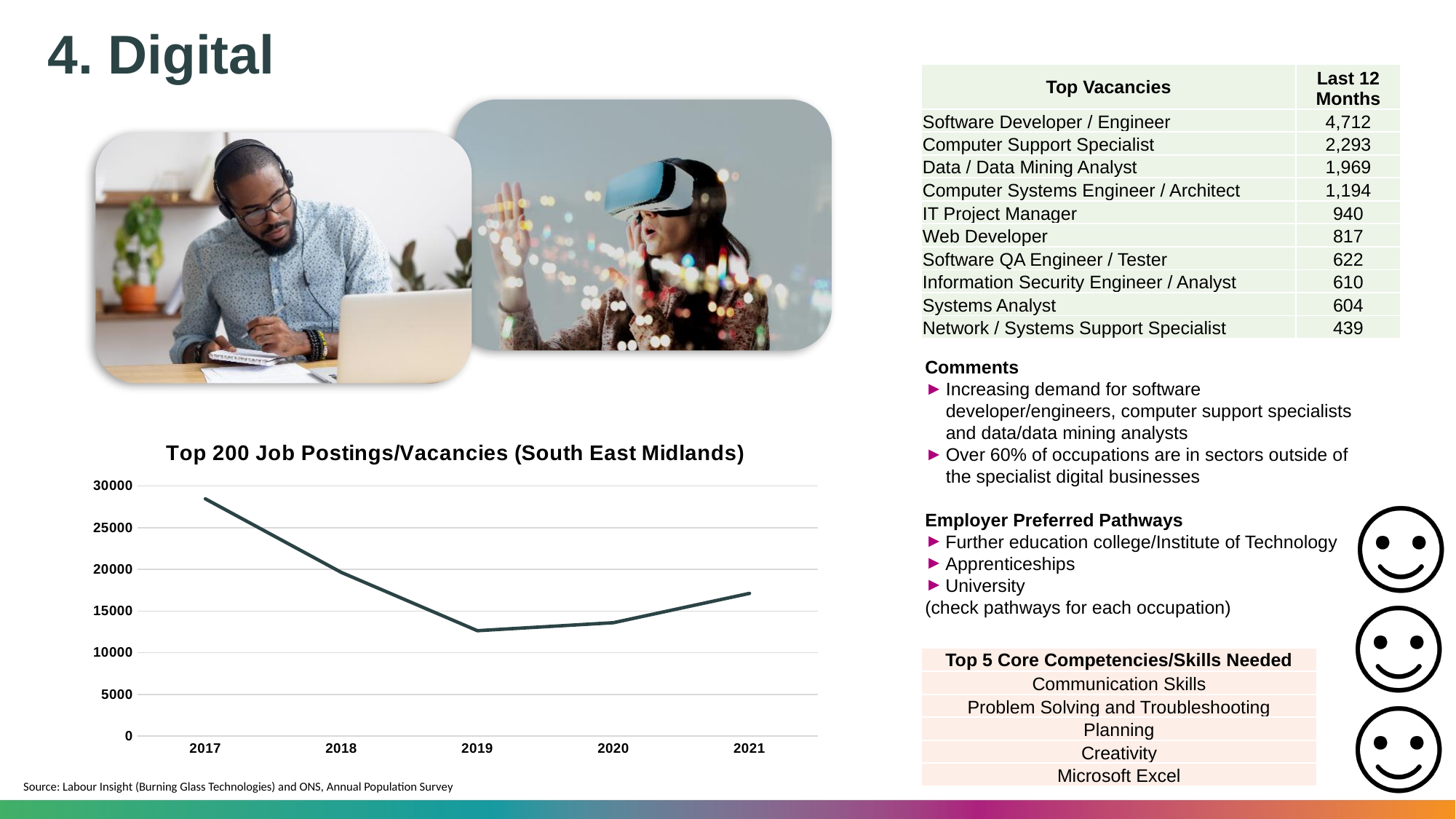
Which year has the highest number of job postings in the chart? 2017 What is the title of the chart? Top 200 Job Postings/Vacancies (South East Midlands) Is the value for 2017 greater or less than 25000? greater What kind of chart is shown on the slide? line chart Is the value for 2019 greater or less than 15000? less How many years are plotted on the x axis of the chart? 5 Do job postings rise or fall from 2019 to 2021? rise Is the value for 2021 greater or less than 20000? less Which year has the lowest number of job postings in the chart? 2019 Which year has more job postings, 2017 or 2021? 2017 Do job postings rise or fall from 2017 to 2019? fall